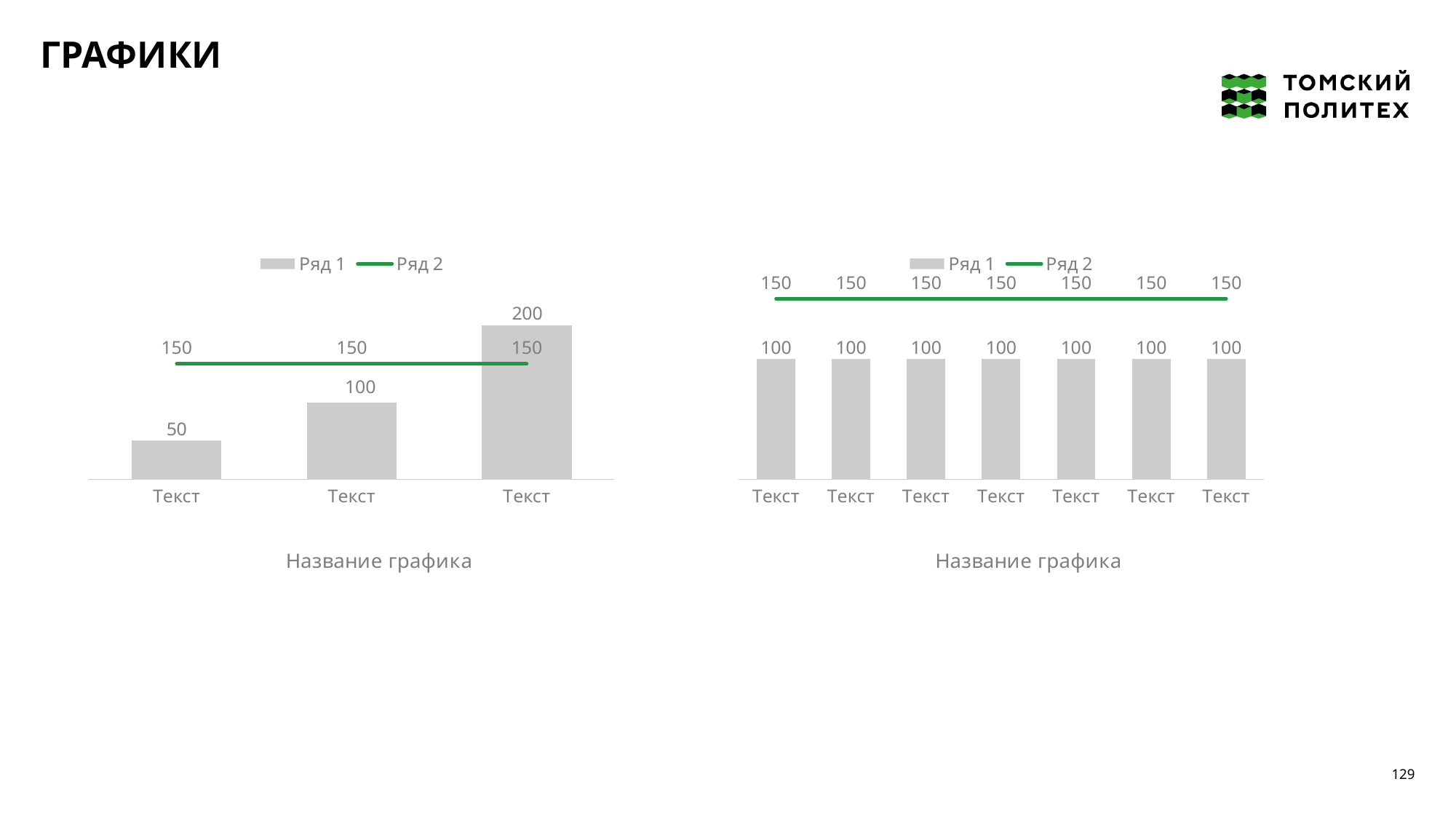
On the left chart, which is larger at the second category: Ряд 1 or Ряд 2? Ряд 2 How many categories does the right chart have? 7 On the left chart, do the values of Ряд 1 rise or fall from left to right? rise On the right chart, what is the value of each bar of Ряд 1? 100 On the left chart, what is the value of the third bar of Ряд 1? 200 On the left chart, what is the difference between the third and first bars of Ряд 1? 150 On the right chart, what is the value of Ряд 2 at the last category? 150 What type of chart is the left chart? combined bar and line chart How many series does the legend of the right chart list? 2 On the left chart, which bar of Ряд 1 is the highest? the third bar (200) On the left chart, what is the value of the first bar of Ряд 1? 50 On the left chart, what is the value of Ряд 2 at the second category? 150